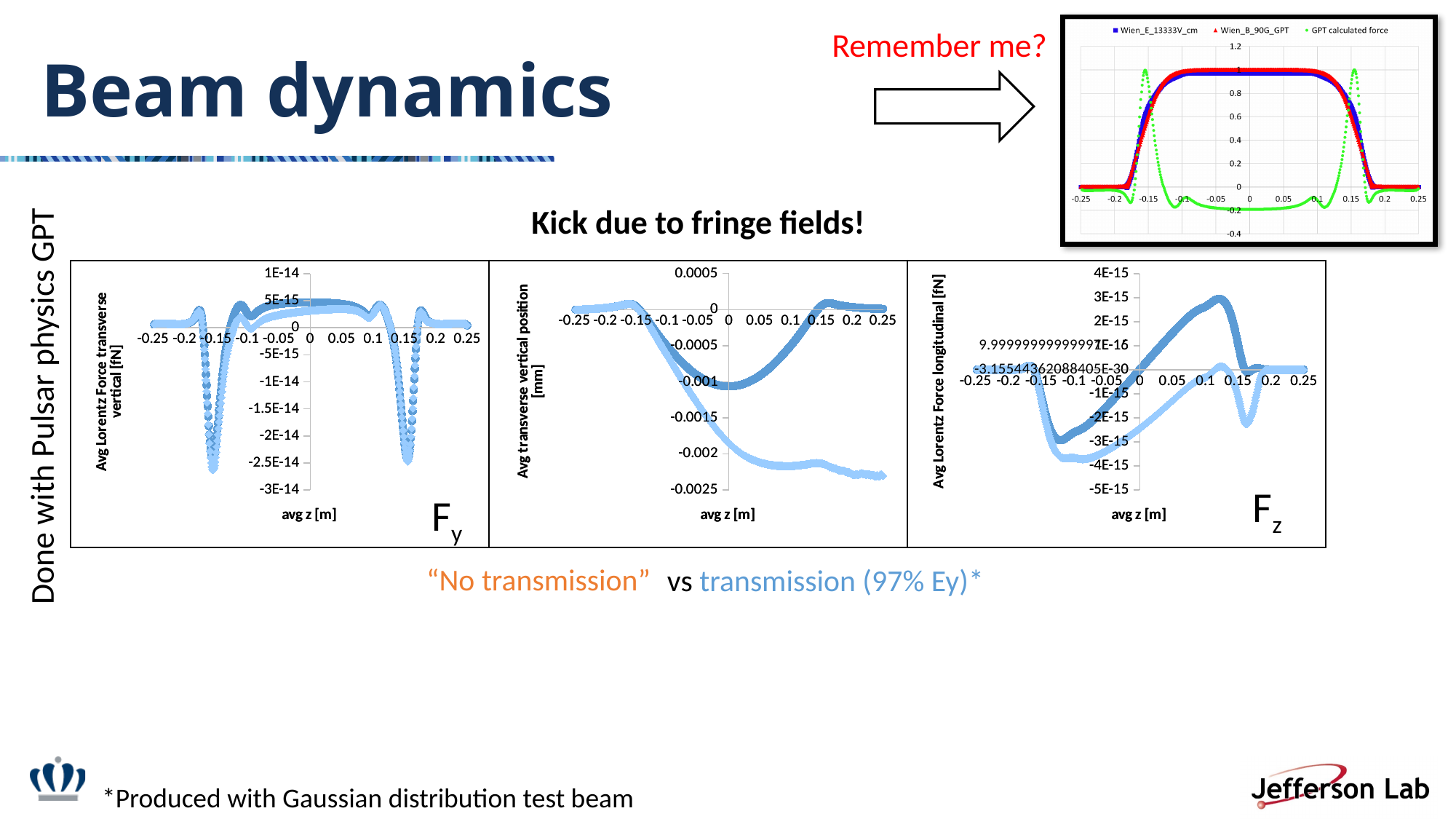
In the middle bottom chart (Avg transverse vertical position), is the light blue series value at avg z = 0.25 greater or less than -0.002? less In the middle bottom chart (Avg transverse vertical position), does the light blue series rise or fall as avg z goes from -0.15 to 0.25? fall In the top-right chart, is the green GPT calculated force value at x = 0 greater or less than 0? less How many charts are shown in the bottom row of the slide? 3 In the Fz chart (bottom right), does the dark blue series rise or fall as avg z goes from -0.15 to 0.1? rise In the top-right chart, what are the three legend entries? Wien_E_13333V_cm, Wien_B_90G_GPT, GPT calculated force In the middle bottom chart (Avg transverse vertical position), is the dark blue series value at avg z = 0 greater or less than -0.0005? less What kind of chart is the Fy chart at the bottom left? scatter chart In the top-right chart, how many series does the legend list? 3 In the Fy chart (bottom left), what is the y-axis label? Avg Lorentz Force transverse vertical [fN]